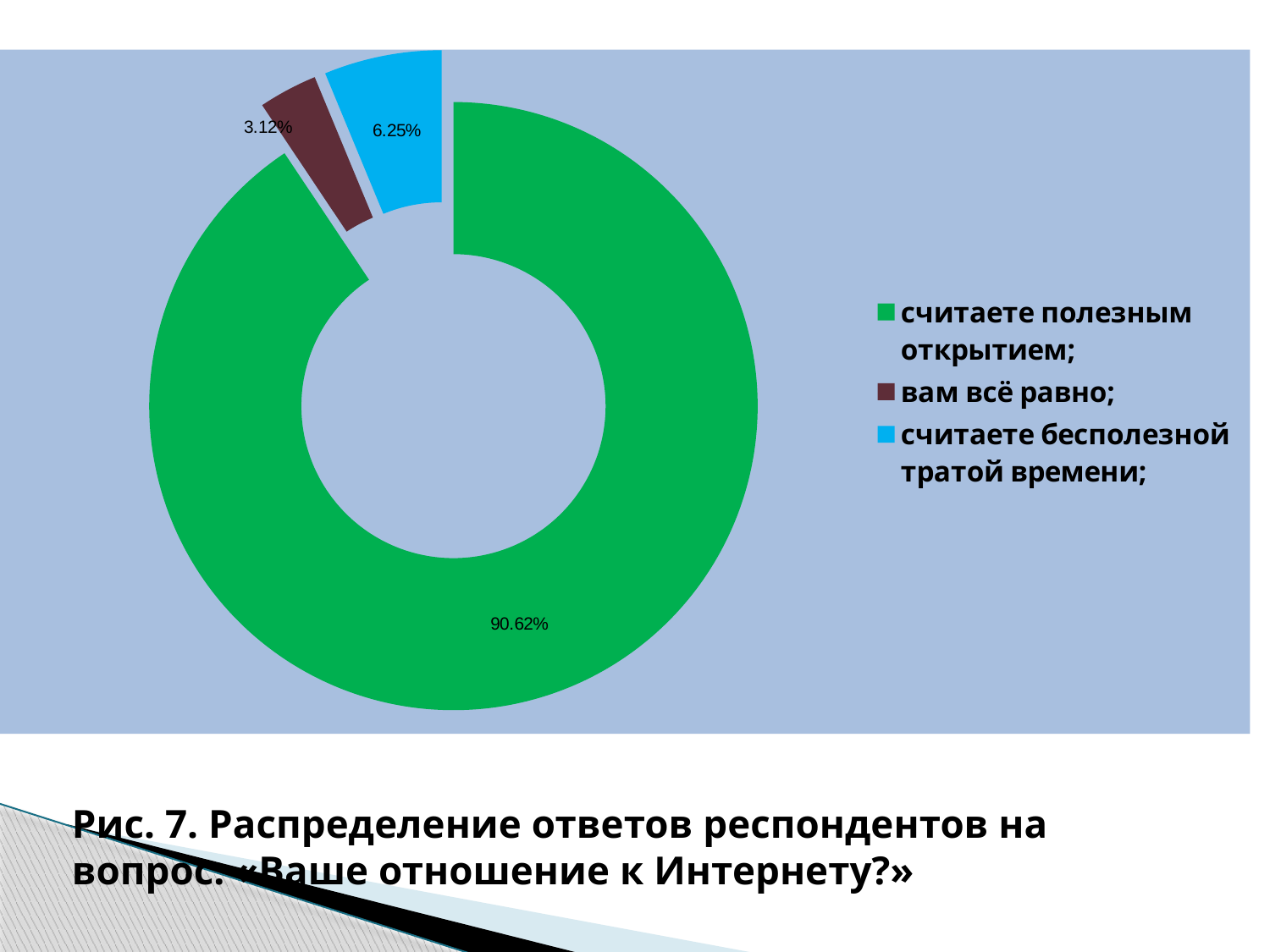
Which answer option has the smallest share? вам всё равно How many entries does the legend list? 3 What share of respondents answered «считаете полезным открытием»? 90.62% Which answer option has the largest share? считаете полезным открытием What kind of chart is shown on the slide? Doughnut (pie) chart How many answer options are shown in the chart? 3 What colour is the slice for «считаете полезным открытием»? Green What share of respondents answered «вам всё равно»? 3.12% What question were respondents asked, according to the caption? «Ваше отношение к Интернету?» Which is larger: the share for «считаете бесполезной тратой времени» or the share for «вам всё равно»? считаете бесполезной тратой времени What is the difference between the shares for «считаете бесполезной тратой времени» and «вам всё равно»? 3.13% What share of respondents answered «считаете бесполезной тратой времени»? 6.25%